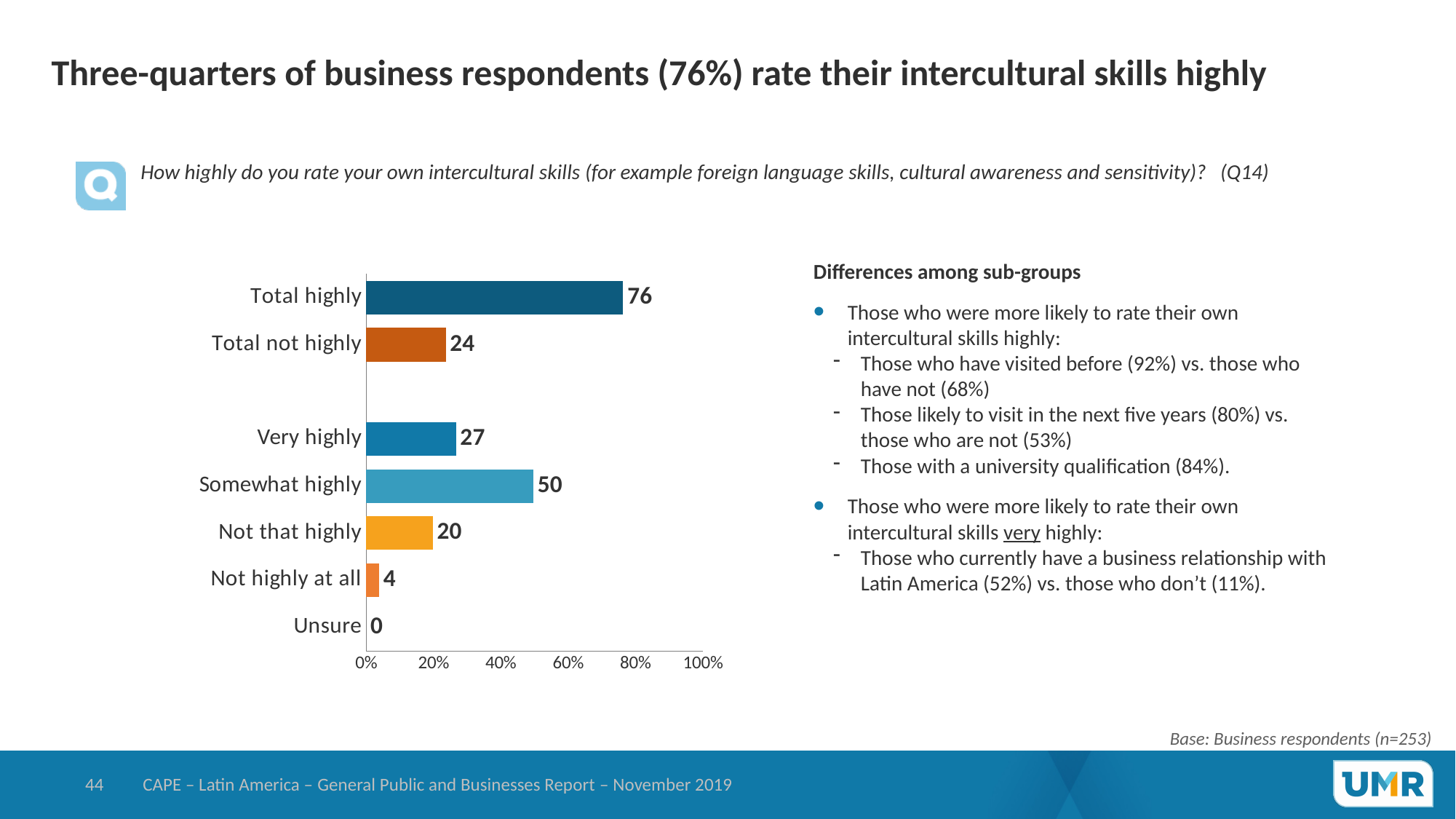
What kind of chart is shown on the slide? Bar chart What is the value for Unsure? 0 What is the difference between Total highly and Total not highly? 52 What is the highest value shown on the x axis? 100% How many categories are shown on the chart? 7 Which category has the highest value? Total highly Which category has the lowest value? Unsure What is the difference between Somewhat highly and Very highly? 23 What is the value for Somewhat highly? 50 What is the value for Total highly? 76 What is the value for Not highly at all? 4 Which is larger, Very highly or Not that highly? Very highly